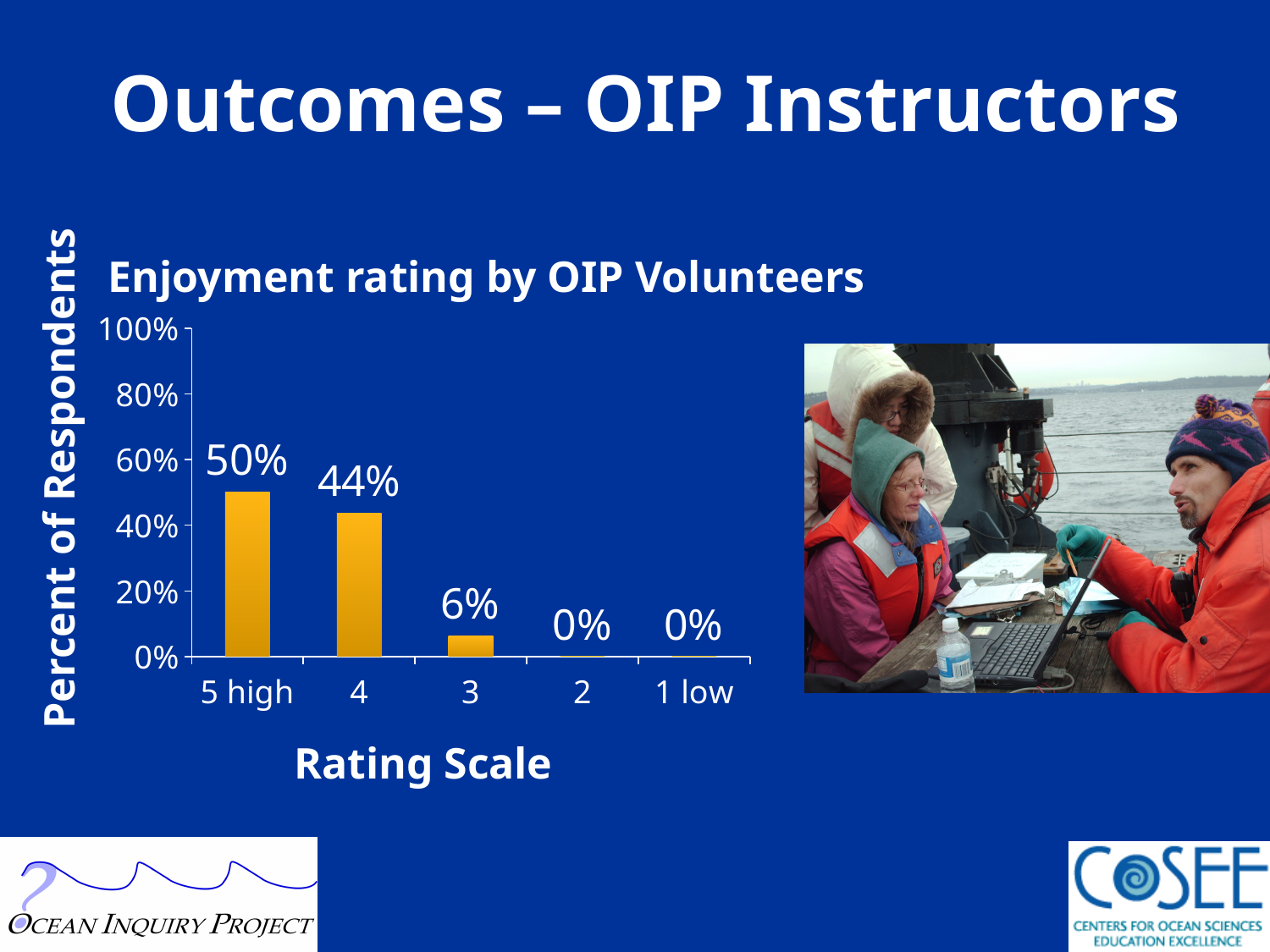
What percentage of respondents gave an enjoyment rating of 1 low? 0% What is the difference in percentage points between the 4 and 3 ratings? 38% What percentage of respondents gave an enjoyment rating of 3? 6% Is the value for rating 4 greater or less than 40%? greater What percentage of respondents gave an enjoyment rating of 5 high? 50% What is the difference in percentage points between the 5 high and 4 ratings? 6% What is the title of the chart? Enjoyment rating by OIP Volunteers What percentage of respondents gave an enjoyment rating of 4? 44% What kind of chart is used to show the enjoyment ratings? Bar chart How many rating categories are shown on the x axis? 5 Which rating category has the highest percentage of respondents? 5 high Which has a larger share of respondents, rating 4 or rating 3? 4